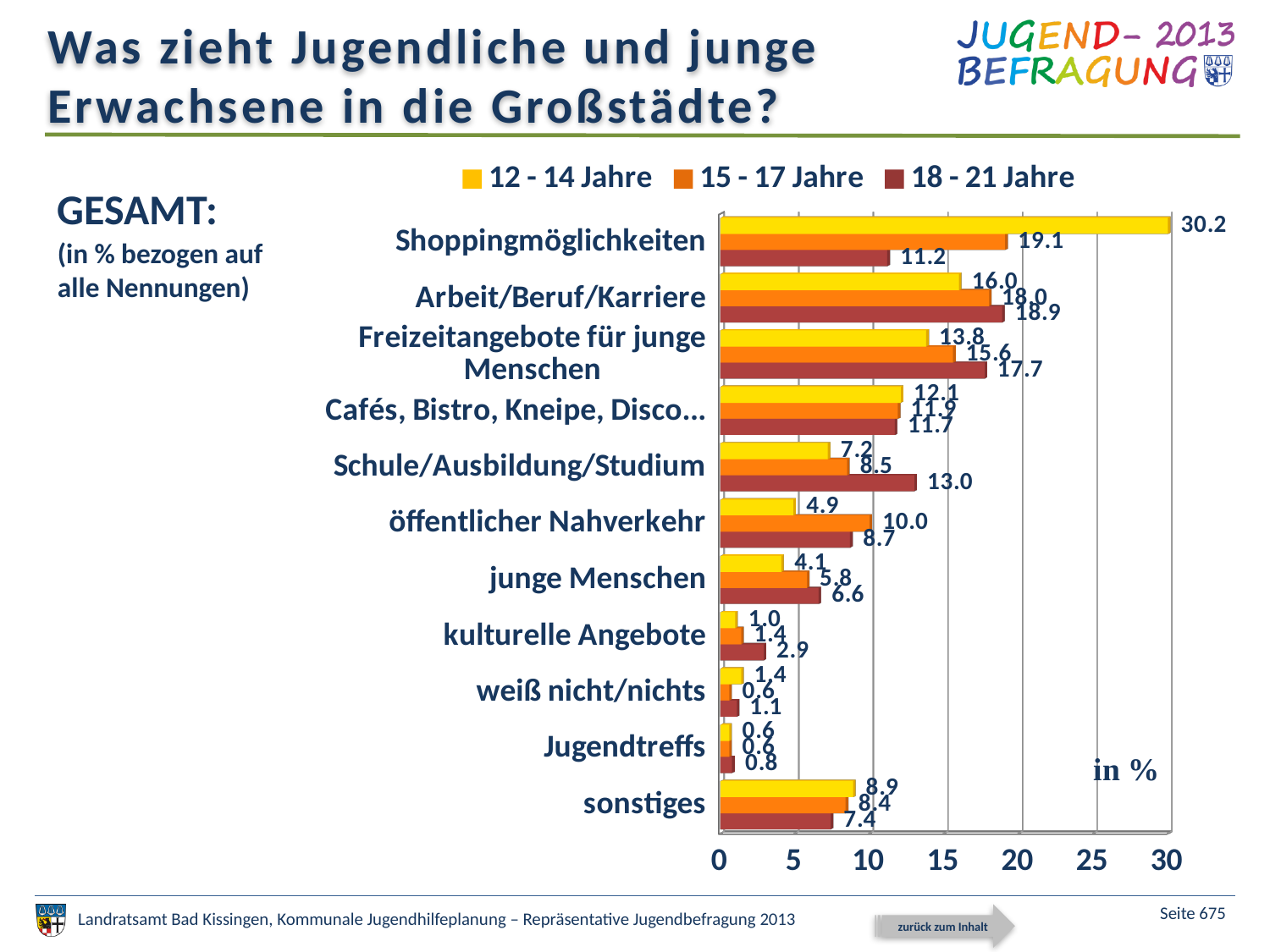
For Schule/Ausbildung/Studium, which series has the larger value: 12 - 14 Jahre or 18 - 21 Jahre? 18 - 21 Jahre What kind of chart is shown on the slide? bar chart What is the value for Shoppingmöglichkeiten in the 12 - 14 Jahre series? 30.2 Which category has the highest value in the 12 - 14 Jahre series? Shoppingmöglichkeiten How many categories are shown on the chart? 11 What is the difference between the 12 - 14 Jahre and 18 - 21 Jahre values for Shoppingmöglichkeiten? 19.0 How many series does the legend list? 3 Which category has the lowest value in the 18 - 21 Jahre series? Jugendtreffs Which series is shown in yellow in the legend? 12 - 14 Jahre What is the value for öffentlicher Nahverkehr in the 15 - 17 Jahre series? 10.0 Is the value for Freizeitangebote für junge Menschen in the 18 - 21 Jahre series greater or less than 15? greater What is the value for Schule/Ausbildung/Studium in the 18 - 21 Jahre series? 13.0